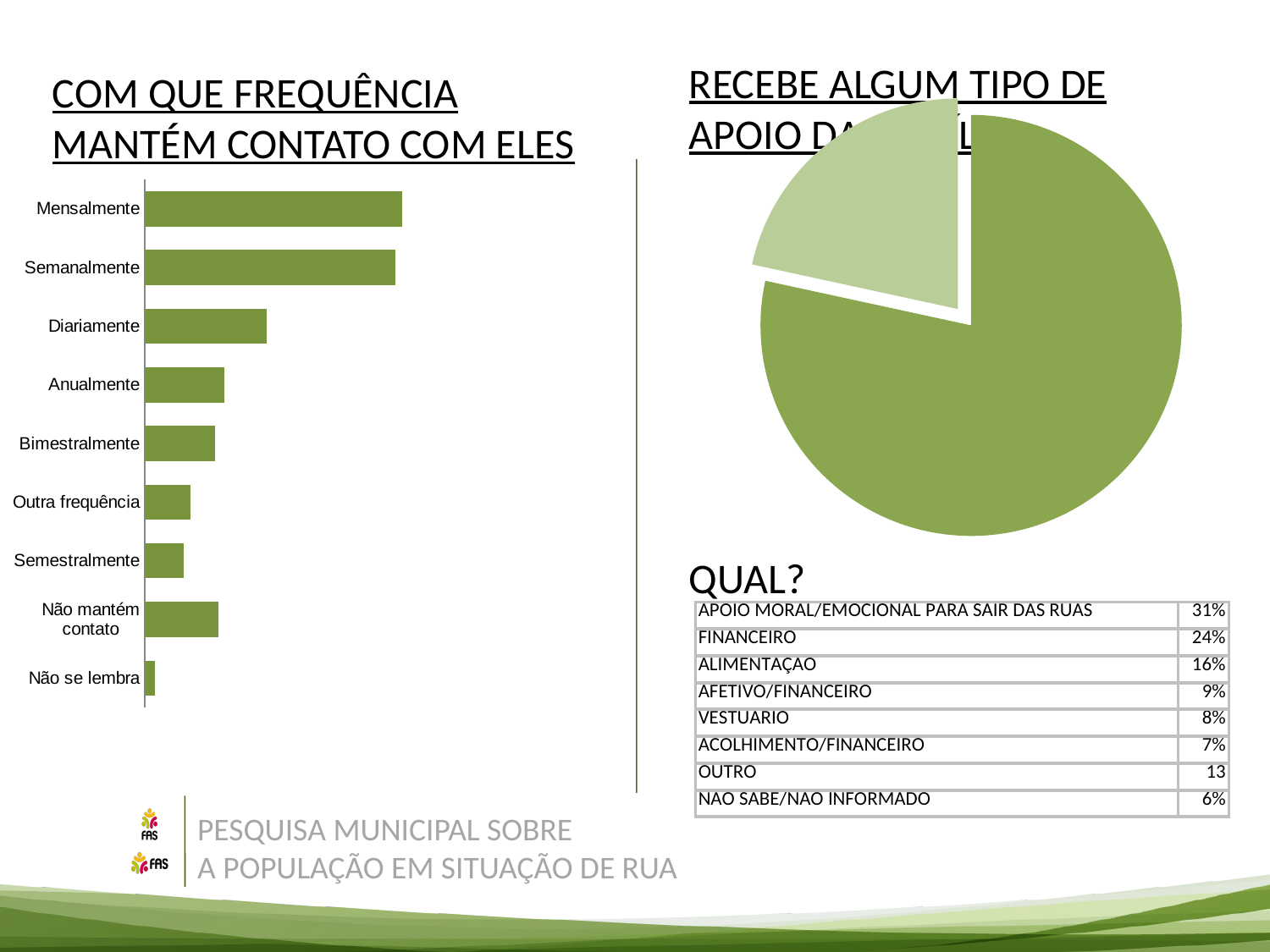
In the bar chart on the left, are the bars drawn horizontally or vertically? Horizontally In the pie chart on the right, how many slices are there? 2 In the bar chart on the left, which is larger: Diariamente or Anualmente? Diariamente What kind of chart is the one on the left of the slide? Bar chart In the bar chart titled "COM QUE FREQUÊNCIA MANTÉM CONTATO COM ELES", which category has the lowest value? Não se lembra What kind of chart is the one on the right of the slide, under the title "RECEBE ALGUM TIPO DE APOIO"? Pie chart In the pie chart on the right, which slice is larger: the dark green one or the light green one? The dark green one In the bar chart on the left, how many categories are shown? 9 In the bar chart on the left, which is larger: Outra frequência or Diariamente? Diariamente In the bar chart on the left, which category is listed at the top of the chart? Mensalmente